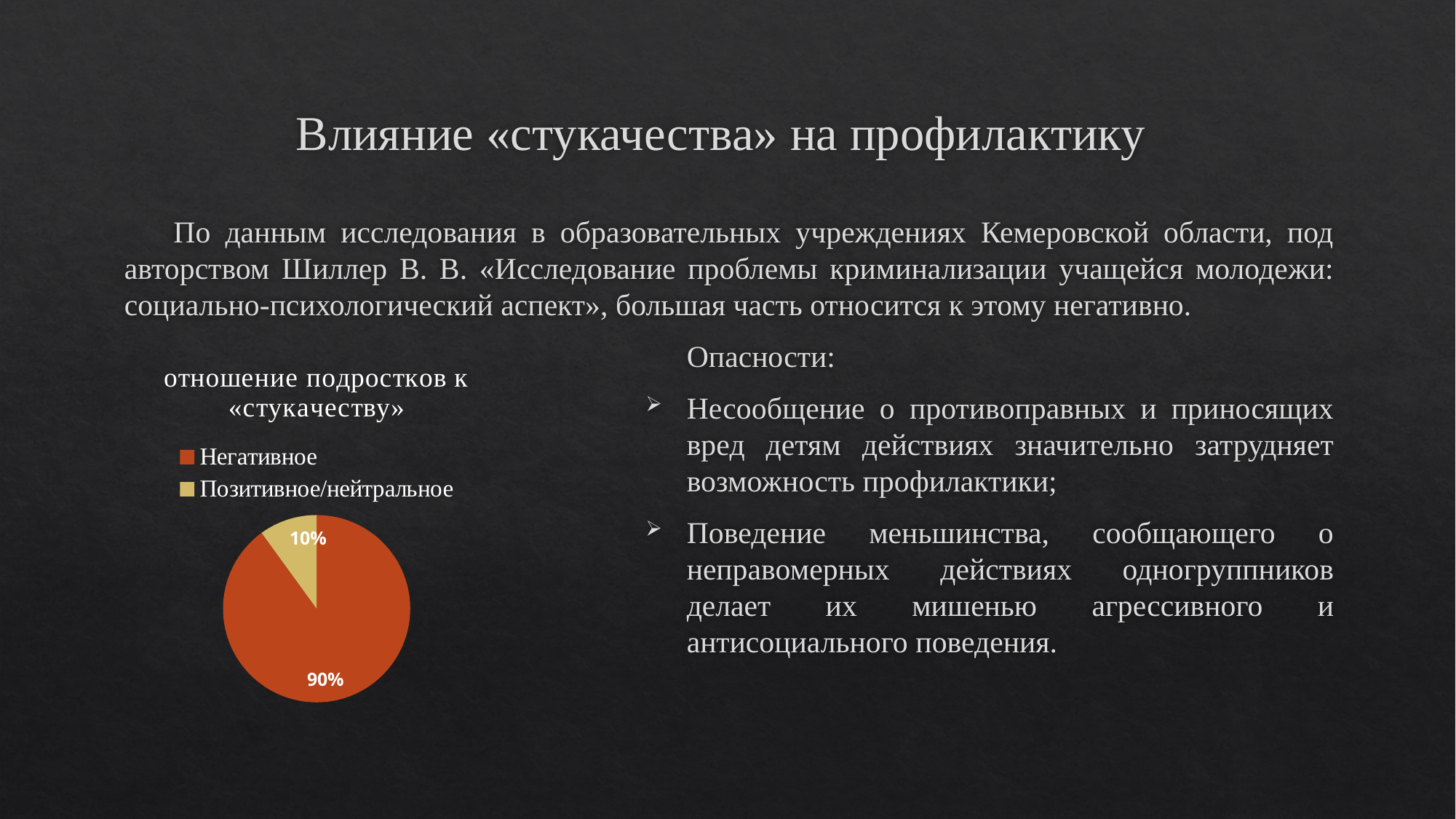
How many entries does the legend list? 2 Which category has the largest slice of the pie? Негативное Which category has the smallest slice of the pie? Позитивное/нейтральное How many categories does the pie chart show? 2 What share of the pie is labelled «Позитивное/нейтральное»? 10% What is the total of the two slices shown in the pie chart? 100% What is the title of the chart? отношение подростков к «стукачеству» What share of the pie is labelled «Негативное»? 90% What is the difference in percentage points between the «Негативное» and «Позитивное/нейтральное» slices? 80 Which is larger: the «Негативное» slice or the «Позитивное/нейтральное» slice? Негативное What kind of chart is shown on the slide? pie chart What colour is the «Негативное» slice? orange-red